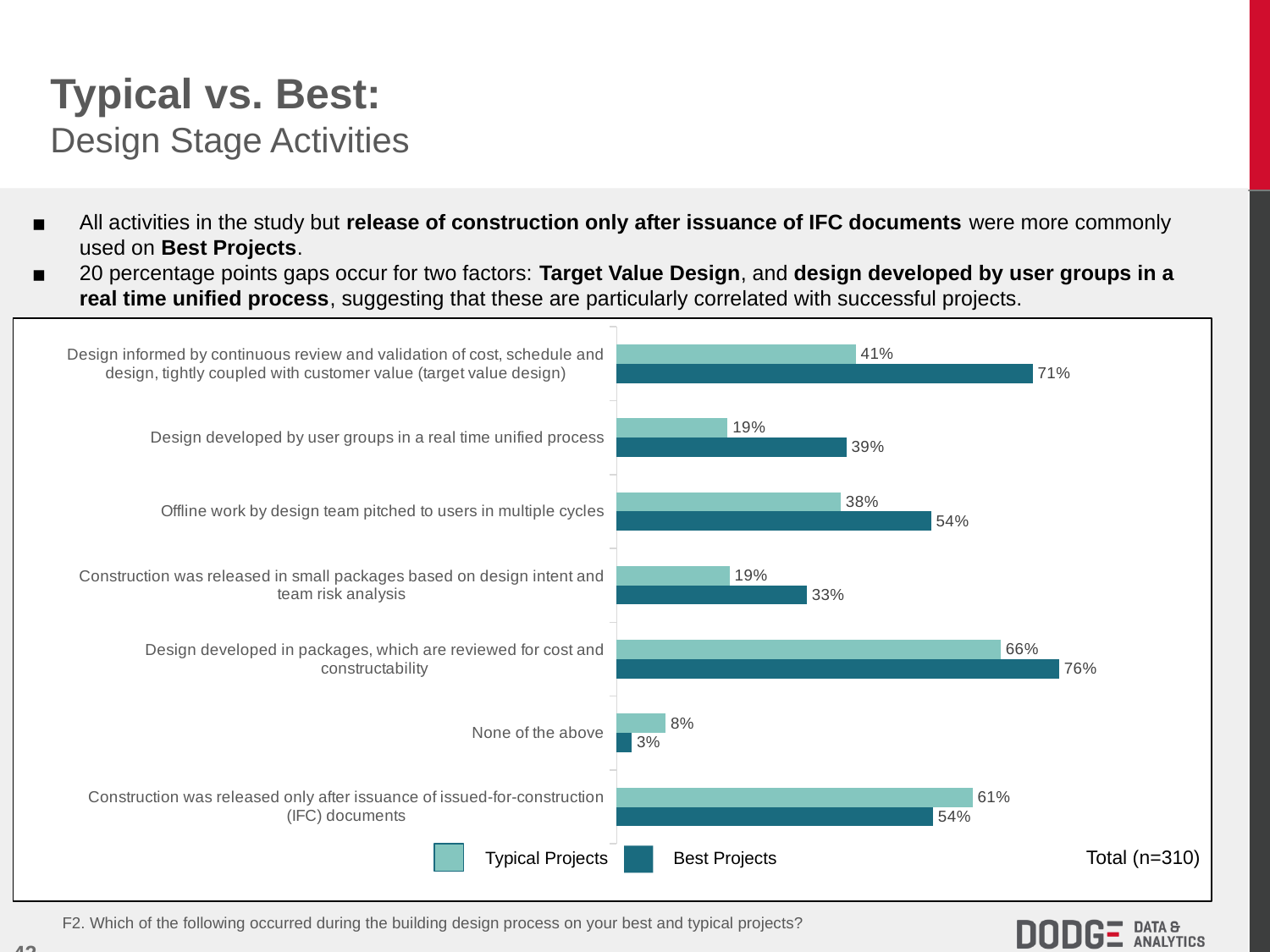
What is the Best Projects value for 'Design informed by continuous review and validation of cost, schedule and design, tightly coupled with customer value (target value design)'? 71% What is the Best Projects value for 'None of the above'? 3% How many categories are shown in the chart? 7 What sample size is noted in the chart? Total (n=310) How many series does the legend list? 2 What is the difference between the Best Projects and Typical Projects values for 'Design developed by user groups in a real time unified process'? 20 percentage points Which category has the lowest Typical Projects value? None of the above What is the Typical Projects value for 'Design developed by user groups in a real time unified process'? 19% For 'Construction was released only after issuance of issued-for-construction (IFC) documents', which is larger: the Typical Projects value or the Best Projects value? Typical Projects What kind of chart is shown on the slide? Bar chart Which category has the highest Best Projects value? Design developed in packages, which are reviewed for cost and constructability What is the Typical Projects value for 'Offline work by design team pitched to users in multiple cycles'? 38%